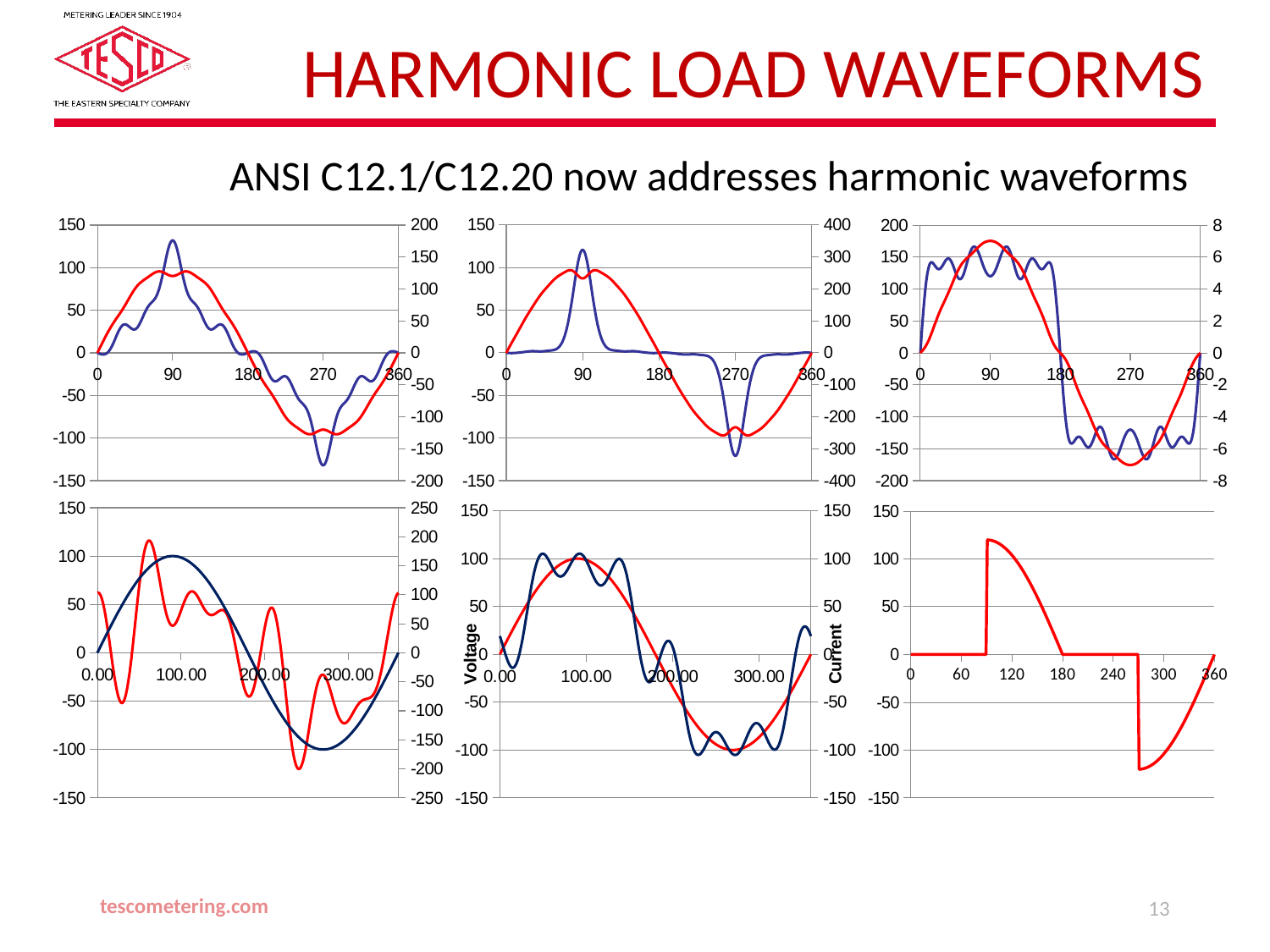
How many lines are plotted in the bottom-right chart? 1 What kind of charts are shown on the slide? Line charts In the bottom-middle chart, what is the title of the left vertical axis? Voltage In the bottom-right chart, is the value of the line at x = 120 greater or less than 50? greater In the bottom-right chart, what is the value of the line at x = 60? 0 How many charts are shown on the slide? 6 In the bottom-right chart, is the value of the line at x = 300 greater or less than -50? less In the bottom-right chart, what is the value of the line at x = 240? 0 In the bottom-middle chart, what is the title of the right vertical axis? Current In the bottom-right chart, does the line rise or fall between x = 300 and x = 360? rise In the bottom-right chart, does the line rise or fall between x = 120 and x = 180? fall